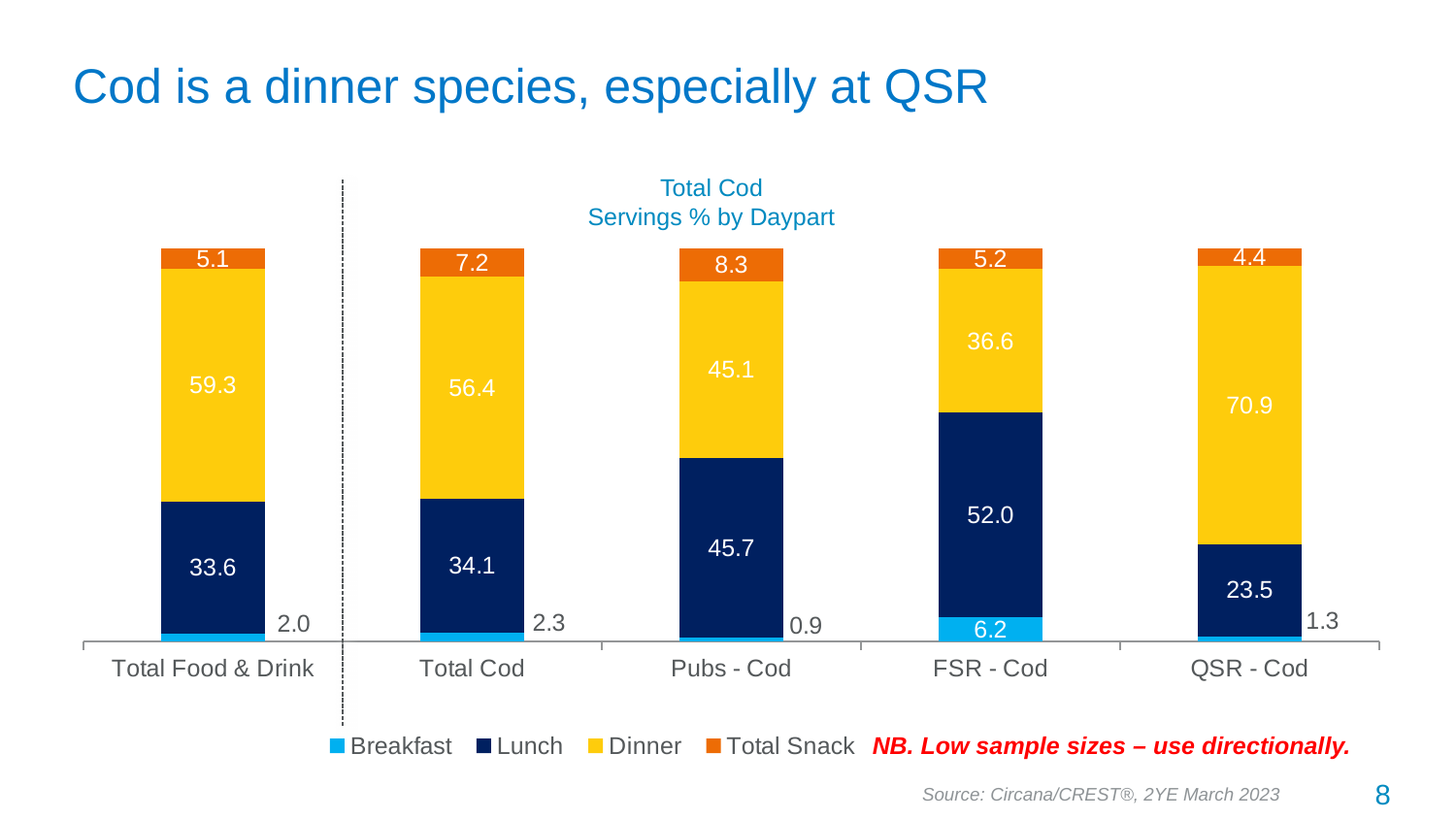
What is the Lunch value for FSR - Cod? 52.0 What is the Total Snack value for Pubs - Cod? 8.3 Which category has the lowest Breakfast value? Pubs - Cod Which category has the highest Dinner value? QSR - Cod How many series does the legend list? 4 What is the Dinner value for QSR - Cod? 70.9 How many categories are shown on the x axis? 5 What kind of chart is shown on the slide? Stacked bar chart Which category has the highest Total Snack value? Pubs - Cod What is the Breakfast value for Total Food & Drink? 2.0 Which is larger, the Lunch value for Total Cod or the Lunch value for Pubs - Cod? Pubs - Cod What is the difference between the Dinner value for QSR - Cod and the Dinner value for FSR - Cod? 34.3